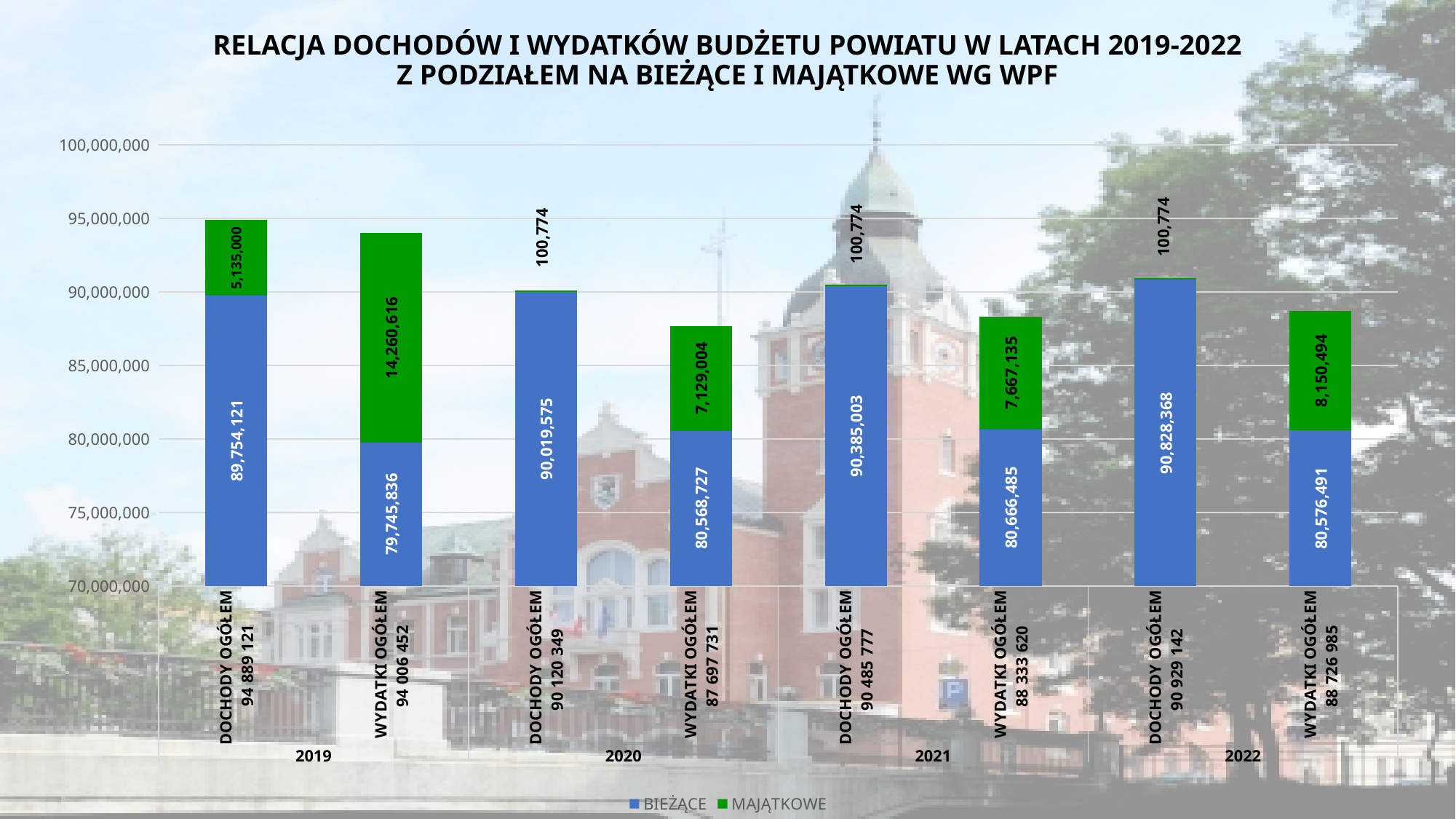
What is the BIEŻĄCE value for DOCHODY OGÓŁEM in 2019? 89,754,121 What is the total of the stacked bar for DOCHODY OGÓŁEM in 2019? 94 889 121 Which bar has the lowest BIEŻĄCE value? WYDATKI OGÓŁEM 2019 How many bars are shown in the chart? 8 What is the MAJĄTKOWE value for DOCHODY OGÓŁEM in 2021? 100,774 What is the difference between the MAJĄTKOWE values for WYDATKI OGÓŁEM in 2022 and 2021? 483,359 What is the BIEŻĄCE value for WYDATKI OGÓŁEM in 2022? 80,576,491 Which is larger, the BIEŻĄCE value for DOCHODY OGÓŁEM in 2020 or in 2021? 2021 Which bar has the highest MAJĄTKOWE value? WYDATKI OGÓŁEM 2019 What is the MAJĄTKOWE value for WYDATKI OGÓŁEM in 2019? 14,260,616 What is the total of the stacked bar for WYDATKI OGÓŁEM in 2021? 88 333 620 How many series does the legend list? 2